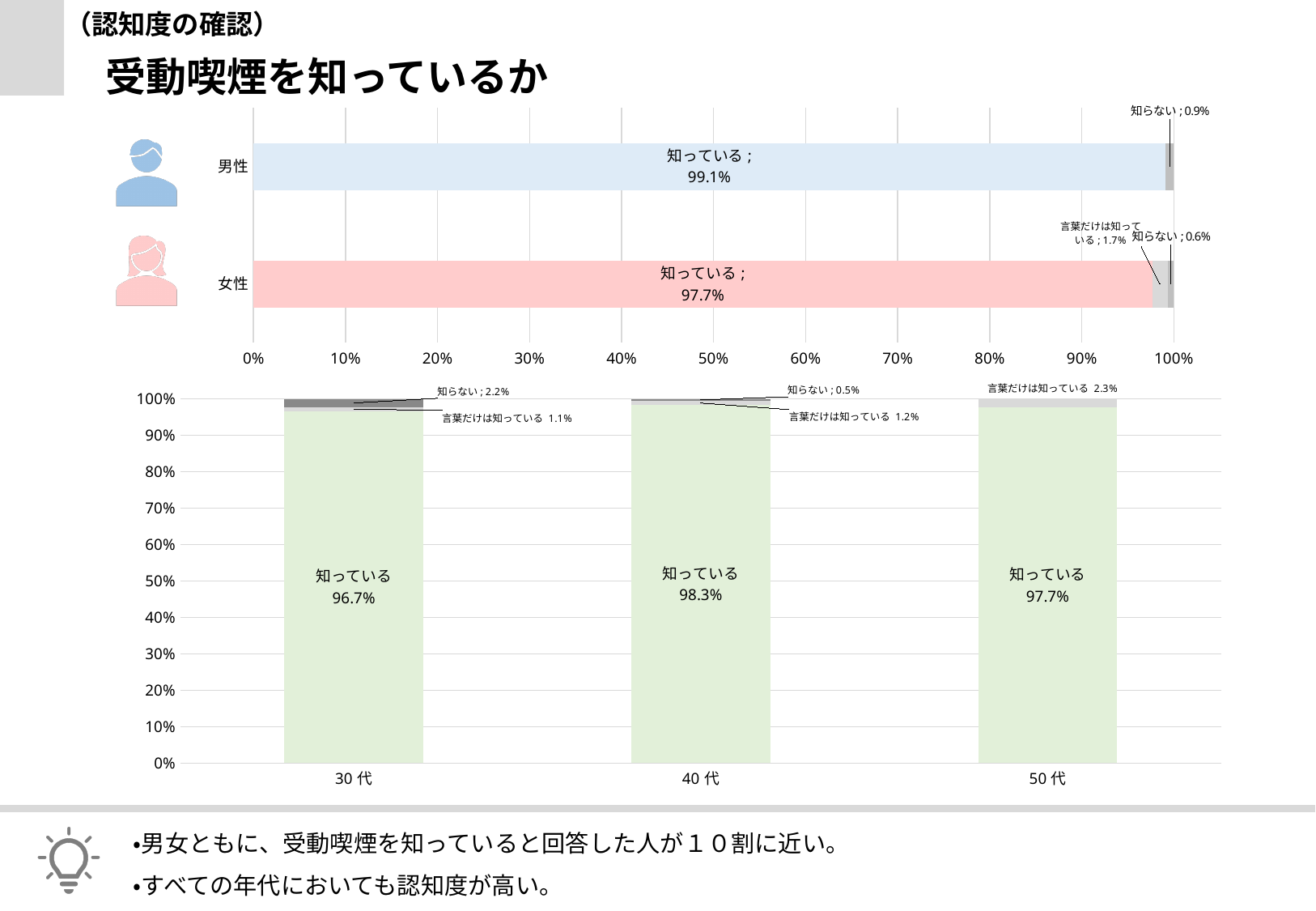
In the top chart (by gender), what percentage of 女性 answered 言葉だけは知っている? 1.7% In the bottom chart (by age group), what is the 知らない value for 30代? 2.2% What kind of chart is the bottom chart (by age group)? Stacked bar chart In the top chart (by gender), what is the 知らない value for 男性? 0.9% In the top chart (by gender), what is the difference between the 知っている values for 男性 and 女性? 1.4% In the top chart (by gender), which group has the higher 知っている percentage, 男性 or 女性? 男性 In the top chart (by gender), what percentage of 女性 answered 知っている? 97.7% In the bottom chart (by age group), which age group has the lowest 知っている percentage? 30代 In the bottom chart (by age group), what percentage of 40代 answered 知っている? 98.3% In the top chart (by gender), what percentage of 男性 answered 知っている? 99.1% In the bottom chart (by age group), what is the 言葉だけは知っている value for 50代? 2.3% In the bottom chart (by age group), how many age groups are shown? 3